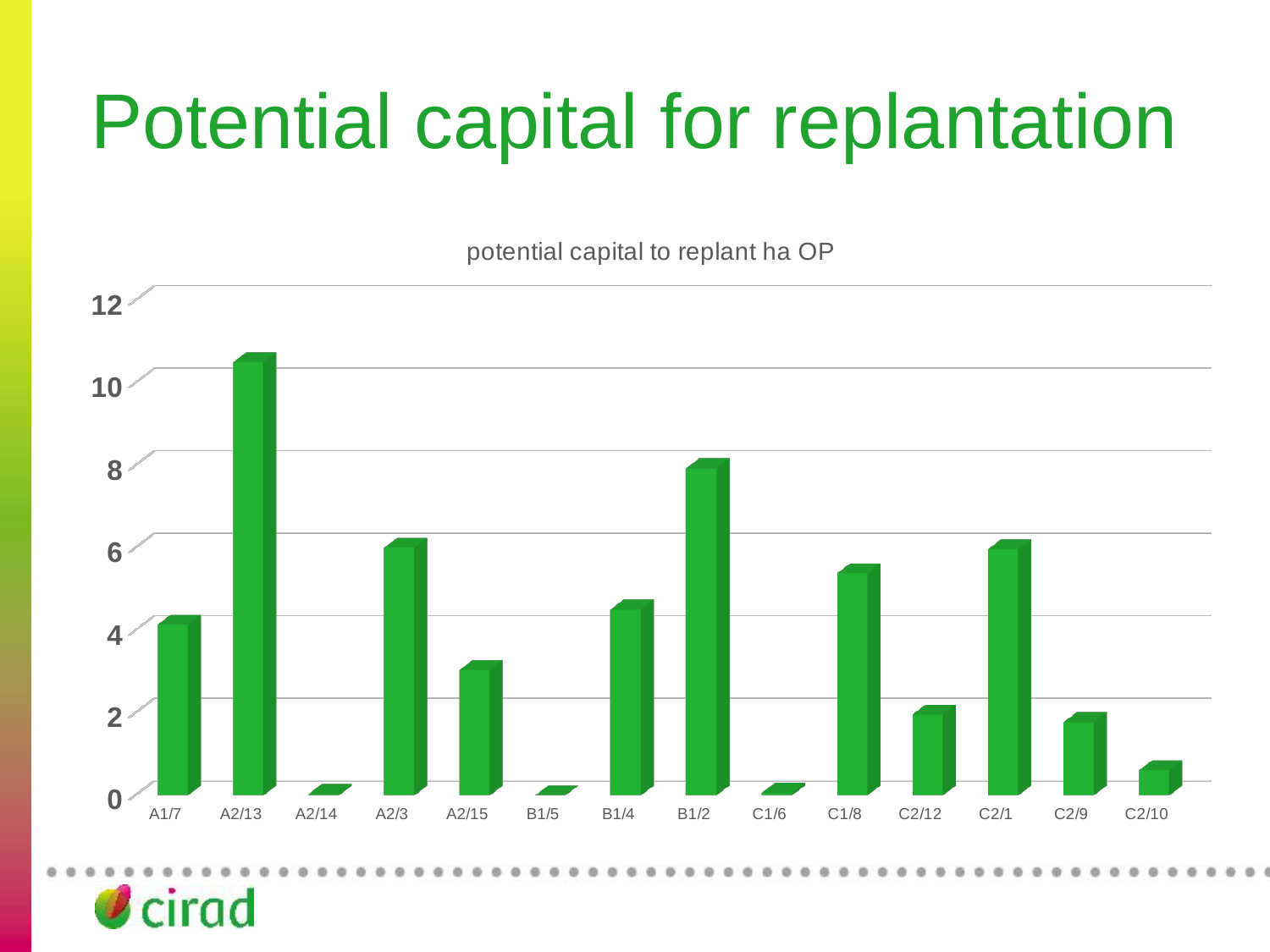
What kind of chart is shown on the slide? bar chart What is the title of the chart? potential capital to replant ha OP Is the value for B1/2 greater or less than 6? greater Is the value for C2/12 greater or less than 4? less Is the value for A1/7 greater or less than 6? less Which is larger, the value for B1/2 or the value for C1/8? B1/2 What colour are the bars in the chart? green Which category has the highest value in the chart? A2/13 How many categories are shown on the x axis of the chart? 14 Which is larger, the value for A2/3 or the value for A2/15? A2/3